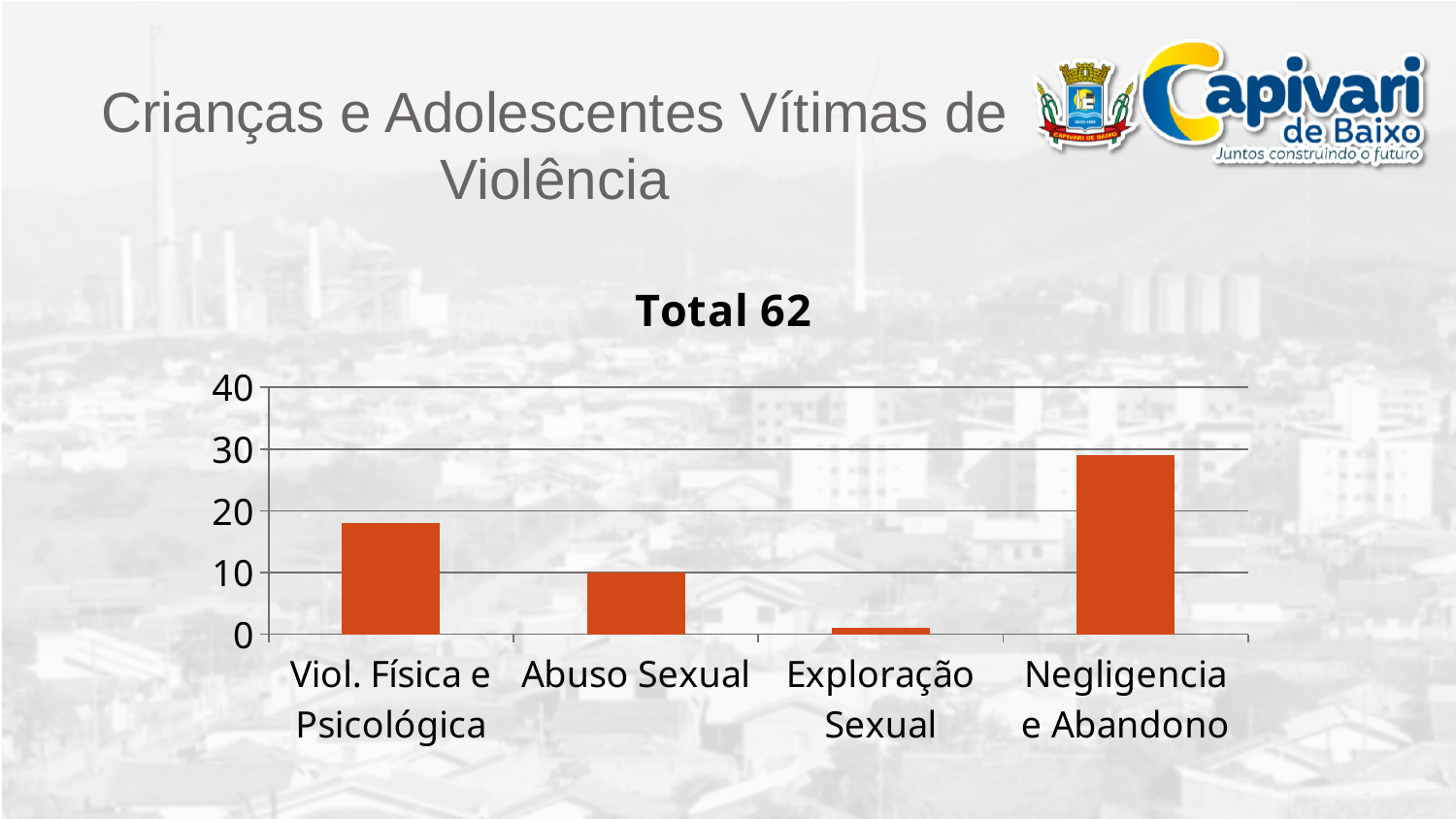
What is the highest value shown on the chart's vertical axis? 40 Which category has the lowest value in the chart? Exploração Sexual Which is larger, the value for Negligencia e Abandono or the value for Viol. Física e Psicológica? Negligencia e Abandono Which category has the highest value in the chart? Negligencia e Abandono What is the title of the chart? Total 62 Is the value for Exploração Sexual greater or less than 10? less Is the value for Negligencia e Abandono greater or less than 20? greater Which is larger, the value for Viol. Física e Psicológica or the value for Abuso Sexual? Viol. Física e Psicológica What kind of chart is shown on the slide? bar chart How many categories are shown on the x axis of the chart? 4 Is the value for Viol. Física e Psicológica greater or less than 20? less